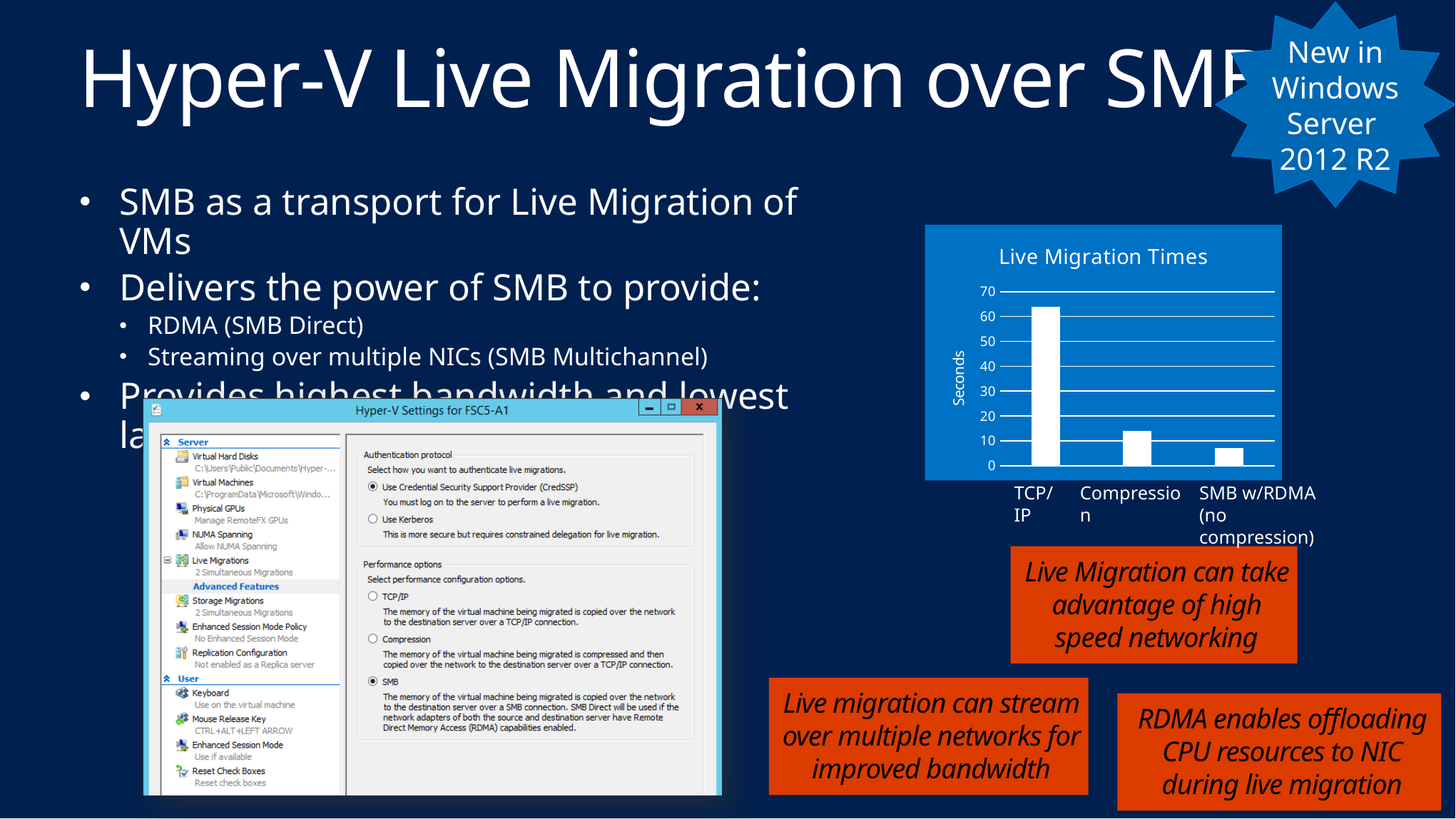
Is the value for TCP/IP greater or less than 60? greater Which category has the highest live migration time? TCP/IP What is the label on the vertical axis of the chart? Seconds Which has a larger value, Compression or SMB w/RDMA (no compression)? Compression Is the value for SMB w/RDMA (no compression) greater or less than 10? less Which has a larger value, TCP/IP or Compression? TCP/IP Is the value for Compression greater or less than 20? less What kind of chart is shown on the slide? bar chart What is the title of the chart? Live Migration Times Do the values rise or fall moving from left to right across the categories? fall How many categories are plotted in the chart? 3 Which category has the lowest live migration time? SMB w/RDMA (no compression)